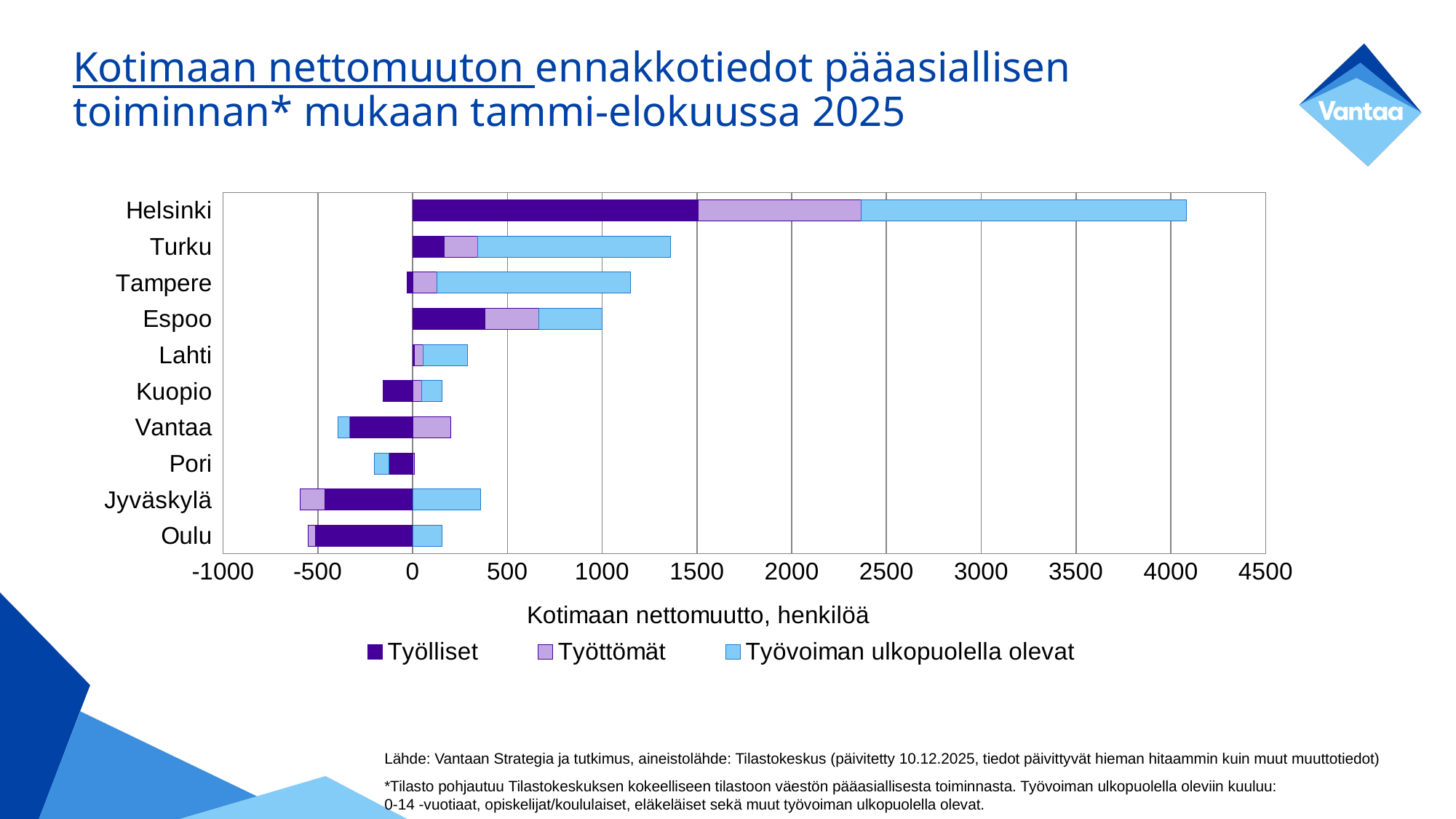
Which series is shown in light blue in the legend? Työvoiman ulkopuolella olevat Is the Työlliset value for Vantaa greater or less than 0? less Which city has the larger total net migration, Turku or Tampere? Turku Is the total net migration value for Helsinki greater or less than 3500? greater What kind of chart is shown on the slide? bar chart How many cities are listed on the vertical axis of the chart? 10 What is the title of the horizontal axis of the chart? Kotimaan nettomuutto, henkilöä Is the Työvoiman ulkopuolella olevat value for Helsinki greater or less than 1500? greater How many series does the legend list? 3 Which city has the longest total bar (highest net migration) in the chart? Helsinki